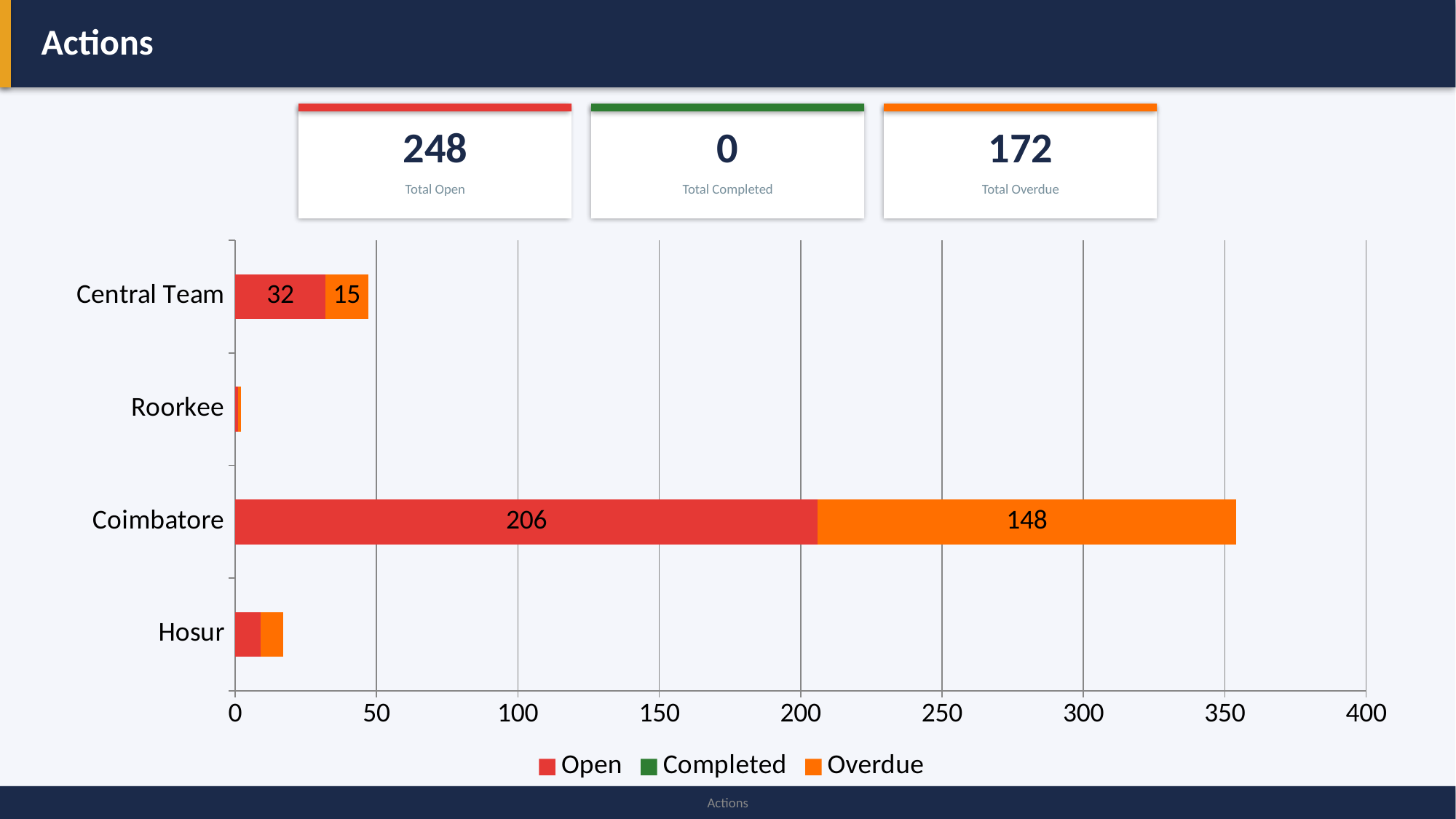
What is the difference between the Open and Overdue values for Coimbatore? 58 Is the Open value for Hosur greater or less than 50? less Which category has the highest Open value? Coimbatore What kind of chart is shown? bar chart What is the total of the stacked bar for Central Team? 47 What is the Overdue value for Central Team? 15 How many categories are shown on the y axis? 4 What is the Overdue value for Coimbatore? 148 What is the Open value for Central Team? 32 What is the Open value for Coimbatore? 206 What is the total of the stacked bar for Coimbatore? 354 How many series does the legend list? 3